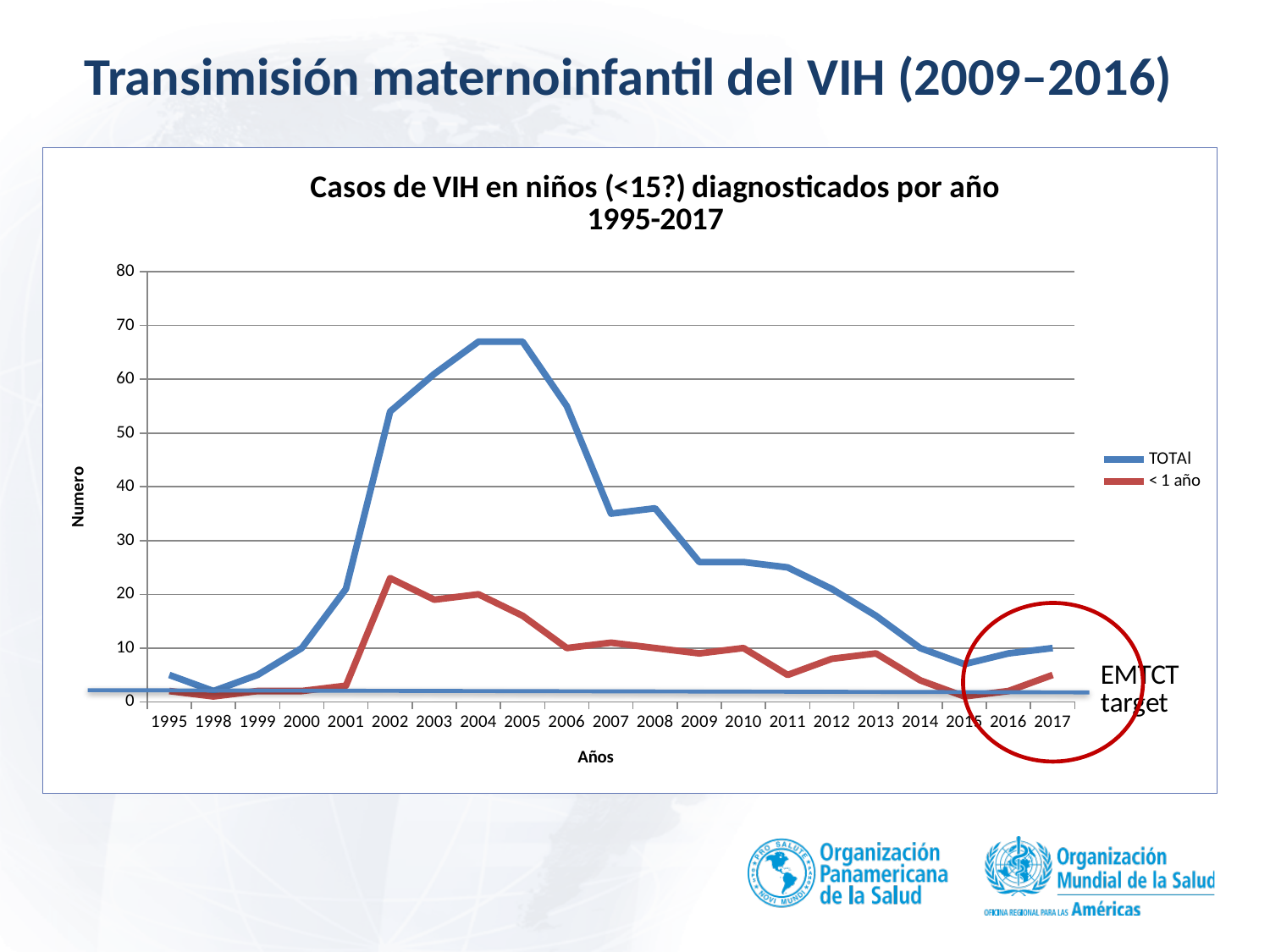
Is the TOTAl value for 2004 greater or less than 60? greater How many years are shown along the x axis? 21 Is the < 1 año value for 2002 greater or less than 20? greater In which year does the < 1 año series reach its highest value? 2002 What kind of chart is shown on the slide? line chart Is the TOTAl value for 2015 greater or less than 10? less Which is larger, the TOTAl value for 2002 or for 2008? 2002 Which year has the lowest TOTAl value? 1998 How many series does the legend list? 2 Does the TOTAl series rise or fall between 2005 and 2015? fall